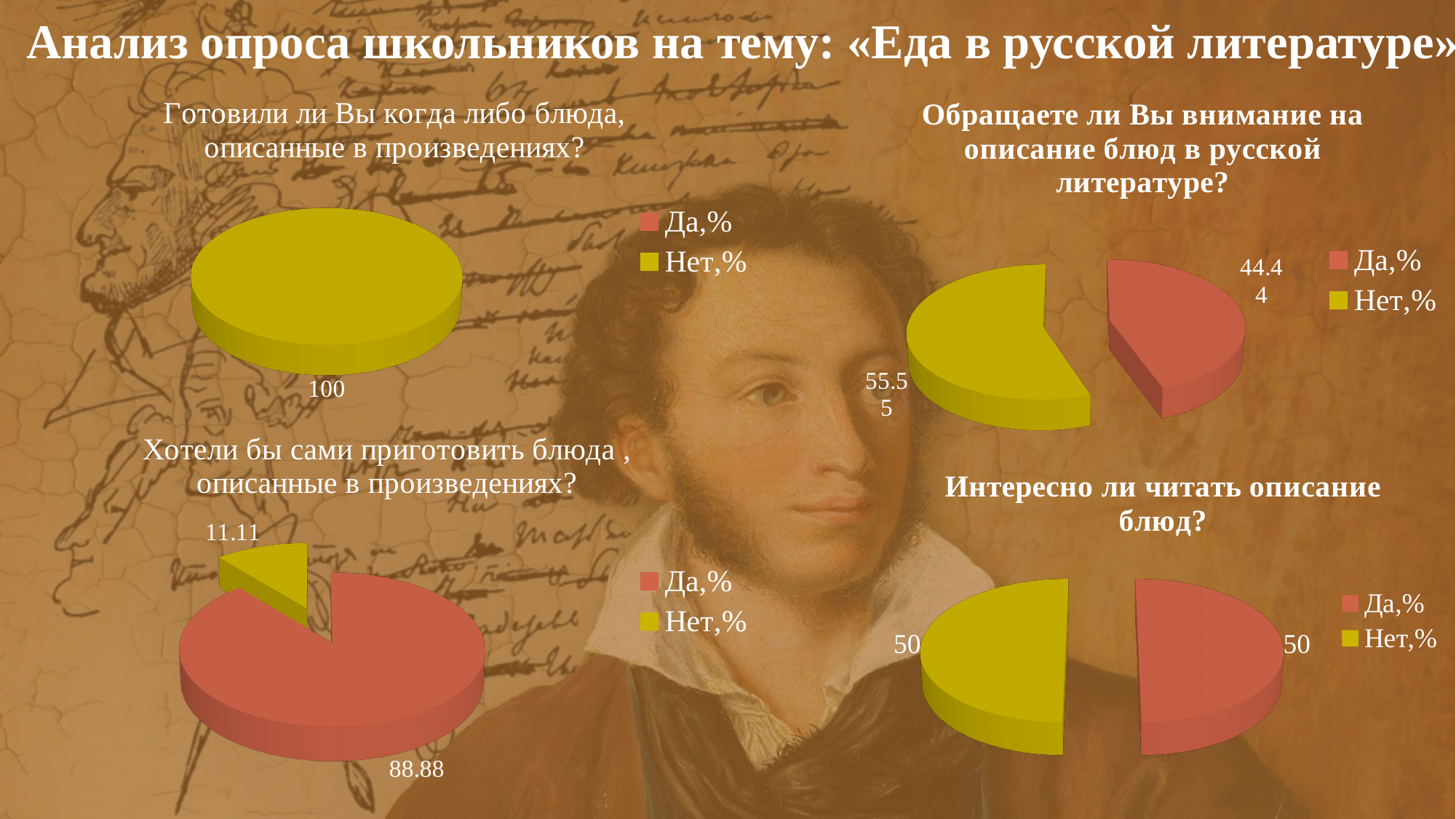
In the chart «Обращаете ли Вы внимание на описание блюд в русской литературе?», which answer has the larger share, Да,% or Нет,%? Нет,% In the chart «Хотели бы сами приготовить блюда, описанные в произведениях?», what is the difference between the values for Да,% and Нет,%? 77.77 What kind of chart is used for the question «Готовили ли Вы когда либо блюда, описанные в произведениях?»? Pie chart In the chart «Хотели бы сами приготовить блюда, описанные в произведениях?», what value is shown for Да,%? 88.88 In the chart «Обращаете ли Вы внимание на описание блюд в русской литературе?», what value is shown for Нет,%? 55.55 How many entries does the legend of the chart «Интересно ли читать описание блюд?» list? 2 In the chart «Хотели бы сами приготовить блюда, описанные в произведениях?», which answer has the largest share? Да,% In the chart «Обращаете ли Вы внимание на описание блюд в русской литературе?», what colour is the Нет,% slice? Yellow In the chart «Интересно ли читать описание блюд?», what value is shown for Да,%? 50 In the chart «Хотели бы сами приготовить блюда, описанные в произведениях?», what value is shown for Нет,%? 11.11 In the chart «Готовили ли Вы когда либо блюда, описанные в произведениях?», what value is shown for Нет,%? 100 In the chart «Обращаете ли Вы внимание на описание блюд в русской литературе?», what value is shown for Да,%? 44.44